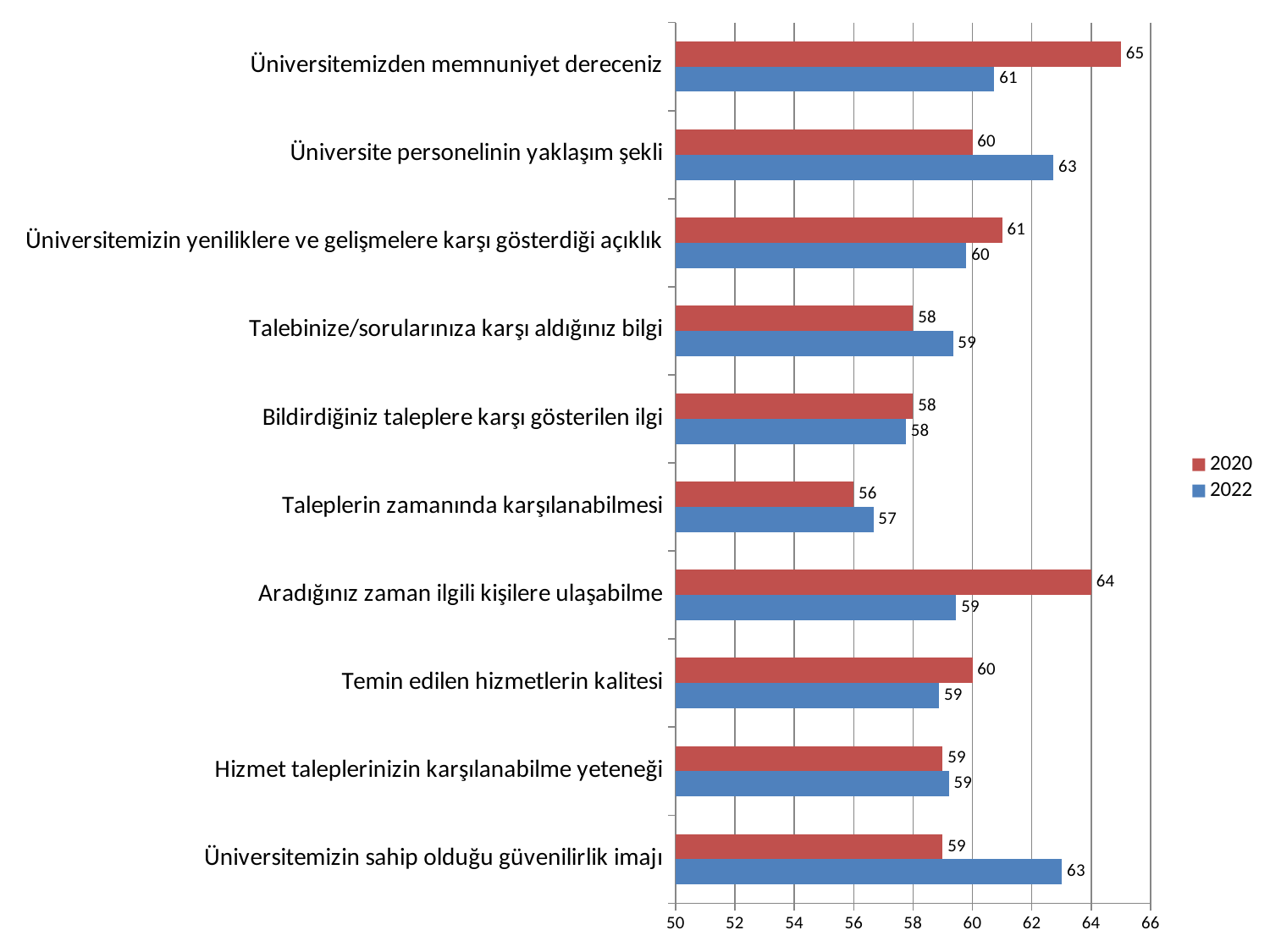
For "Üniversitemizin sahip olduğu güvenilirlik imajı", which year has the larger value, 2020 or 2022? 2022 Which category has the highest 2020 value? Üniversitemizden memnuniyet dereceniz How many categories are shown on the chart? 10 Which colour represents the 2022 series? Blue Is the 2020 value for "Aradığınız zaman ilgili kişilere ulaşabilme" greater or less than 62? greater What is the difference between the 2020 and 2022 values for "Aradığınız zaman ilgili kişilere ulaşabilme"? 5 What is the 2022 value for "Taleplerin zamanında karşılanabilmesi"? 57 How many series does the legend list? 2 Which category has the lowest 2022 value? Taleplerin zamanında karşılanabilmesi What is the 2020 value for "Üniversitemizden memnuniyet dereceniz"? 65 What is the 2022 value for "Üniversite personelinin yaklaşım şekli"? 63 What kind of chart is shown on the slide? Bar chart